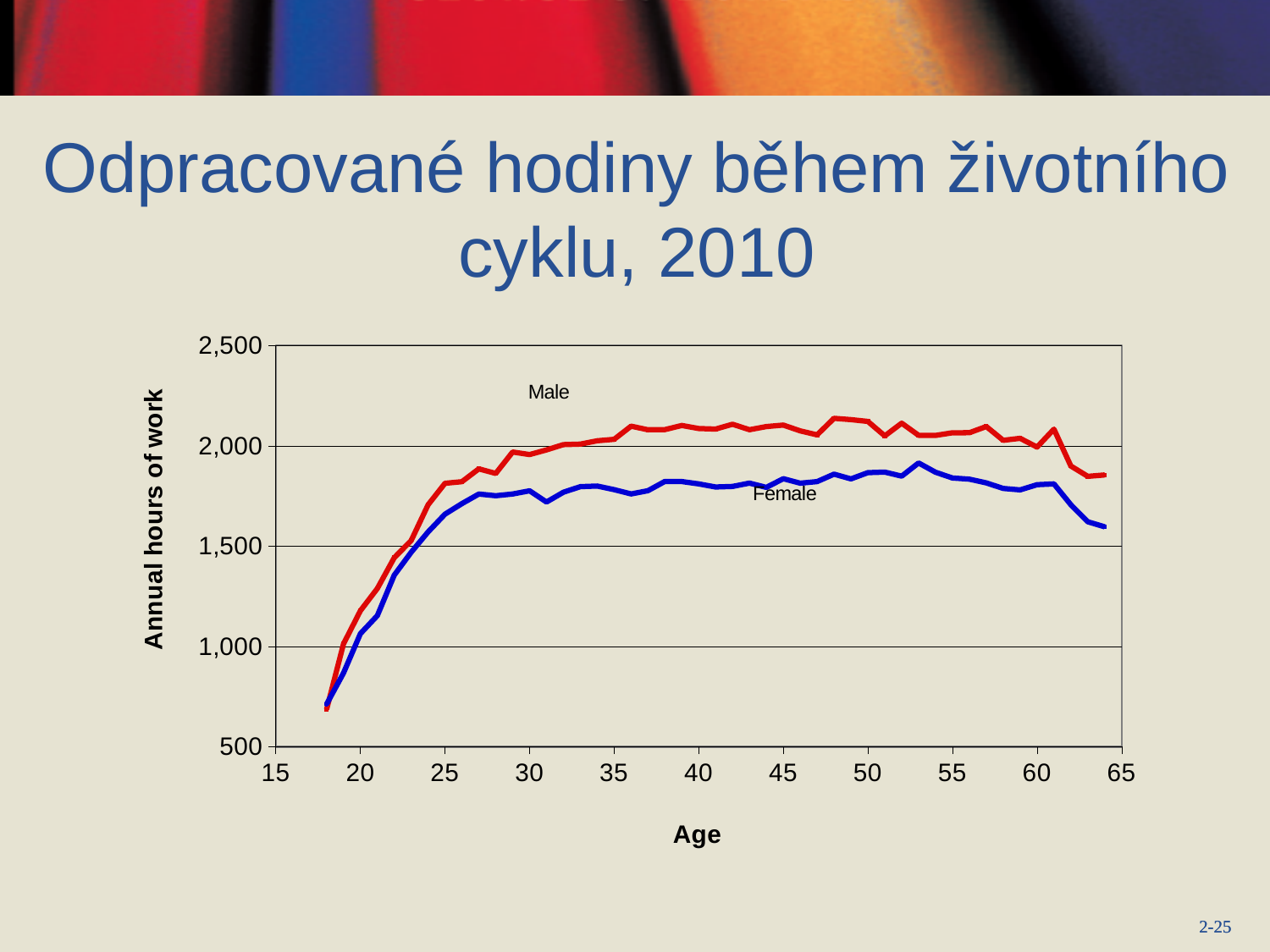
How many series are plotted on the chart? 2 Do the Female values rise or fall between ages 61 and 64? fall Is the value for Male at age 20 greater or less than 1,000? greater Is the value for Male at age 25 greater or less than 1,500? greater Which series is plotted in red? Male Do the Male values rise or fall between ages 18 and 25? rise What is the title of the vertical axis? Annual hours of work At age 45, which series has the higher value, Male or Female? Male Is the value for Male at age 40 greater or less than 2,000? greater What kind of chart is shown on the slide? line chart